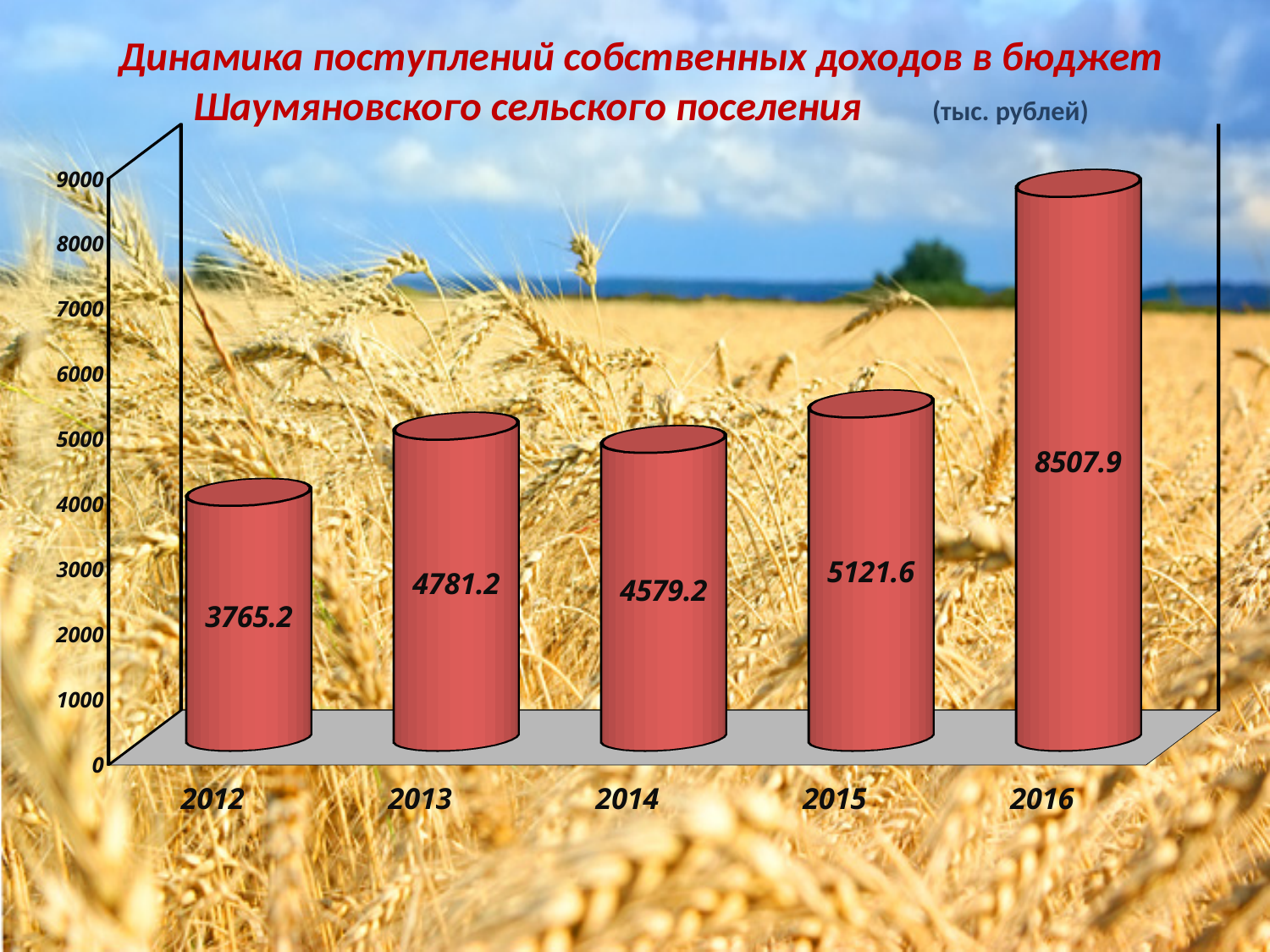
How many years are shown on the chart? 5 Which is larger, the value for 2013 or the value for 2014? 2013 What is the value for 2016? 8507.9 What is the difference between the values for 2016 and 2015? 3386.3 What is the difference between the values for 2013 and 2014? 202.0 What is the value for 2014? 4579.2 What unit is given in the chart title? тыс. рублей Is the value for 2015 greater or less than 5000? greater What is the value for 2012? 3765.2 Which year has the lowest value? 2012 What kind of chart is shown on the slide? bar chart Which year has the highest value? 2016